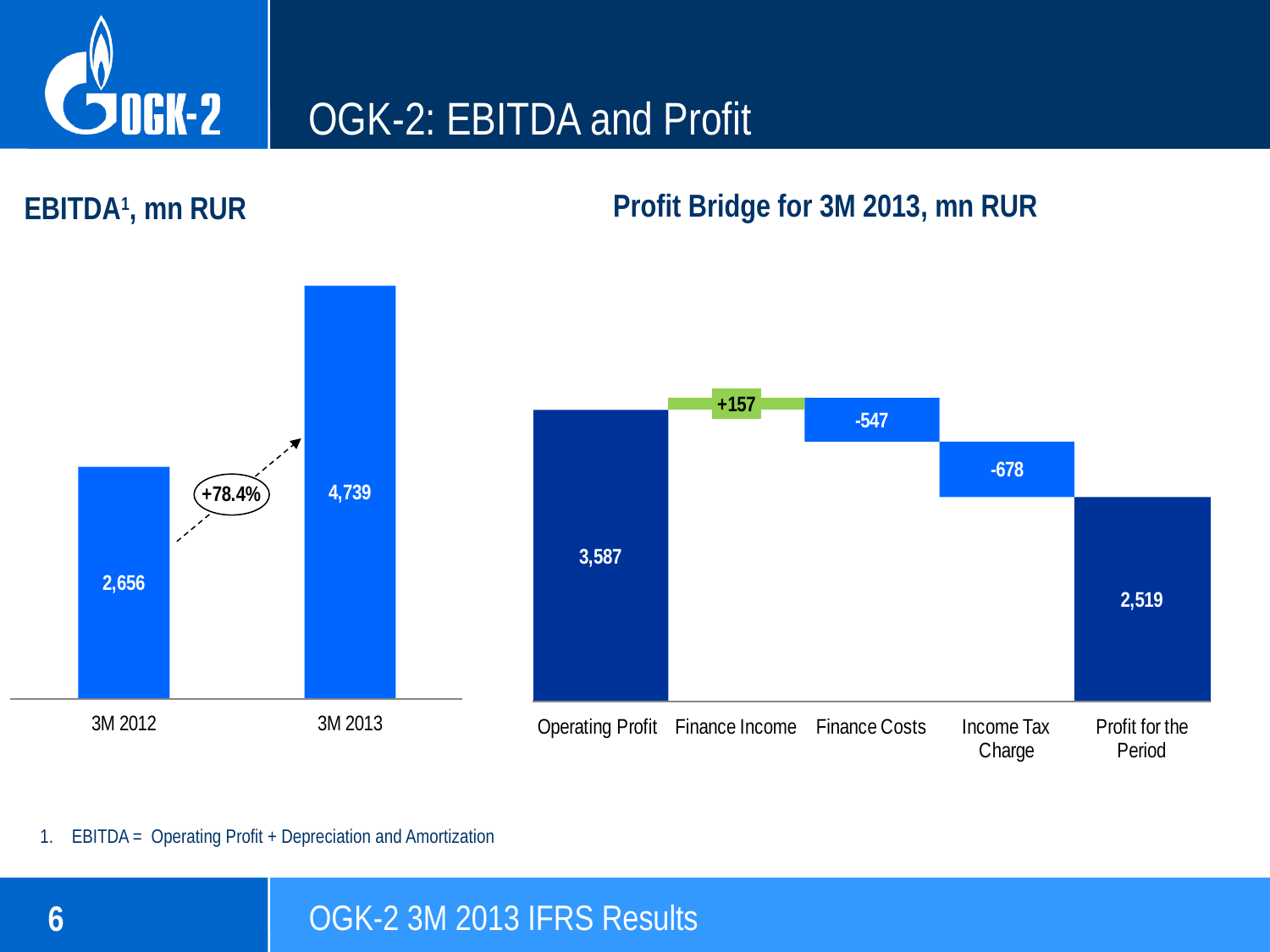
In the EBITDA chart, do values rise or fall from 3M 2012 to 3M 2013? rise In the Profit Bridge for 3M 2013 chart, how many categories are shown on the x axis? 5 In the Profit Bridge for 3M 2013 chart, what is the value for Operating Profit? 3,587 In the Profit Bridge for 3M 2013 chart, what is the value for Finance Income? +157 In the EBITDA chart, how many periods are plotted? 2 In the Profit Bridge for 3M 2013 chart, what is the value for Profit for the Period? 2,519 In the EBITDA chart, what is the difference between the 3M 2013 and 3M 2012 values? 2,083 In the Profit Bridge for 3M 2013 chart, what is the value for Income Tax Charge? -678 In the Profit Bridge for 3M 2013 chart, which is larger in magnitude, Finance Costs or Income Tax Charge? Income Tax Charge In the EBITDA chart, what percentage change is shown between 3M 2012 and 3M 2013? +78.4% In the EBITDA chart, what is the EBITDA value for 3M 2012? 2,656 In the EBITDA chart, what is the EBITDA value for 3M 2013? 4,739